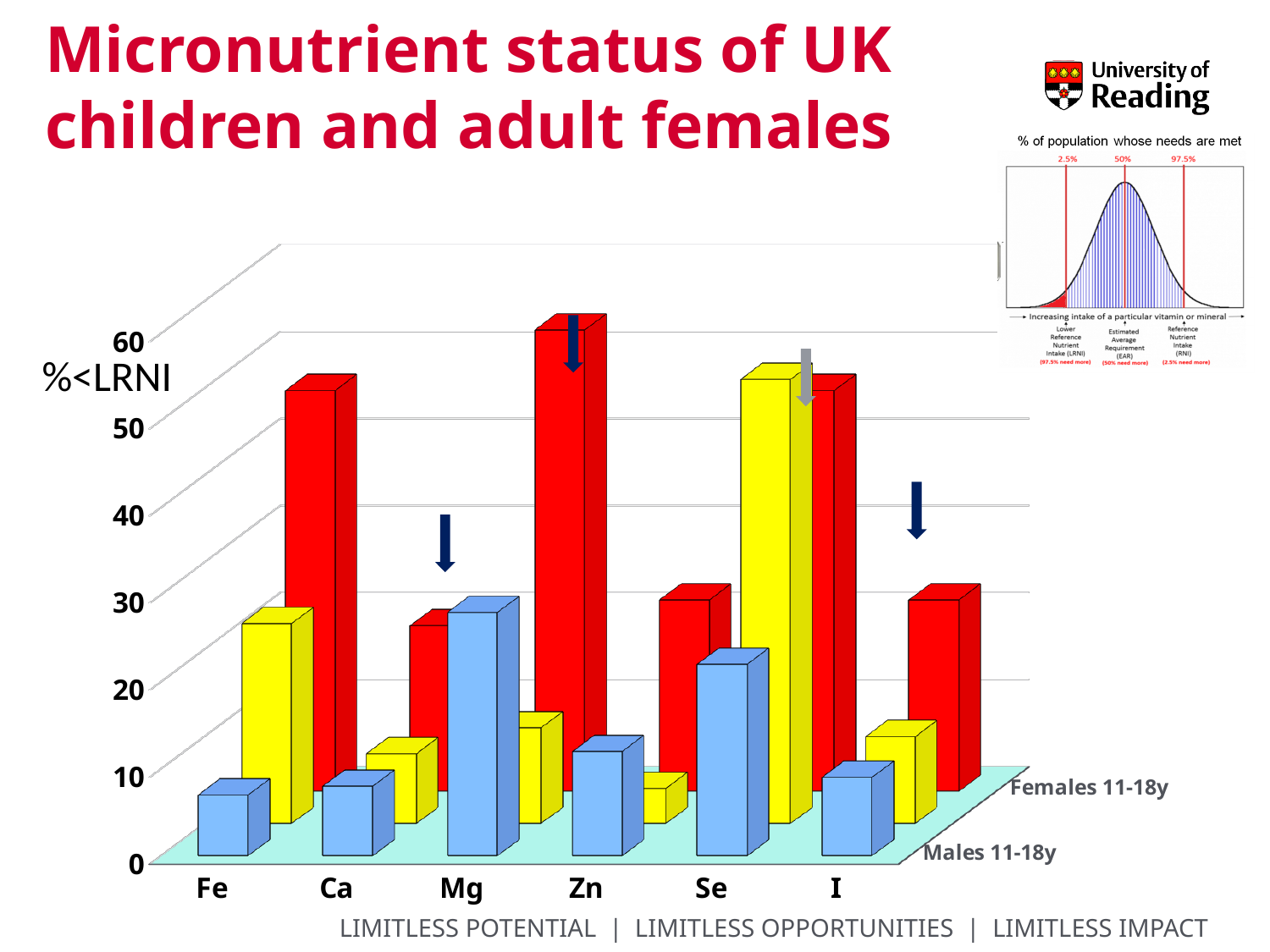
Is the Females 11-18y bar for Se greater or less than 40? greater Is the Males 11-18y bar for Fe greater or less than 20? less Which is larger for Males 11-18y: the value for Mg or the value for Fe? Mg Is the red bar for Fe greater or less than 40? greater How many micronutrient categories are shown along the x axis? 6 Among the red bars, which micronutrient has the highest value? Mg Among the Males 11-18y (blue) bars, which micronutrient has the highest value? Mg What colour are the bars for the Males 11-18y series? blue What kind of chart is shown on the slide? bar chart What is the label on the vertical axis of the chart? %<LRNI